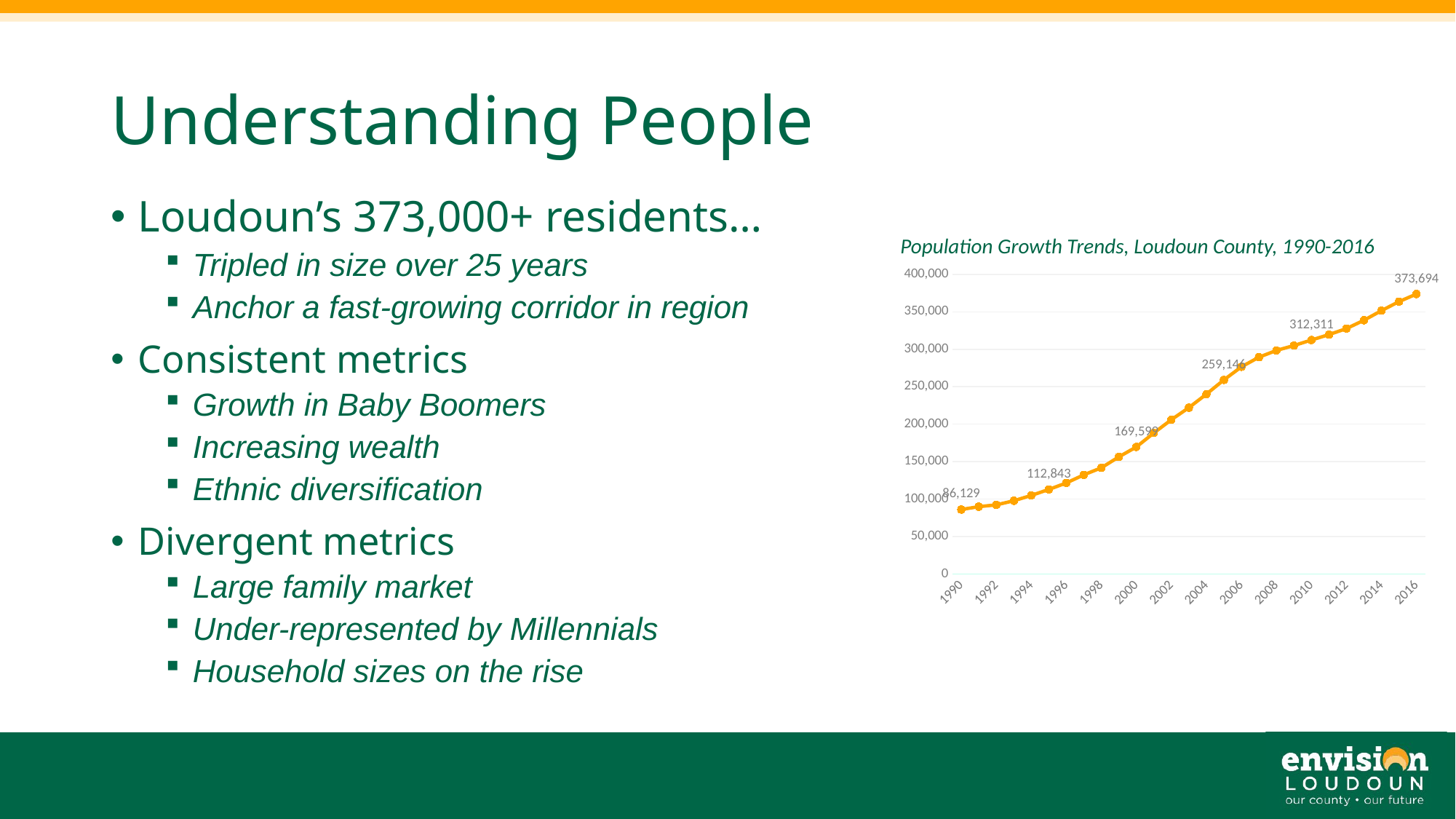
What is the population value shown for 2016? 373,694 What is the difference between the 2016 value (373,694) and the 1990 value (86,129)? 287,565 What type of chart is shown on the slide? Line chart Which year has the lowest population value? 1990 Does the population rise or fall from 1990 to 2016? Rise What is the population value labelled for 2000? 169,599 Which year has the highest population value? 2016 What is the title of the chart? Population Growth Trends, Loudoun County, 1990-2016 Is the value for 2008 greater or less than 250,000? greater What is the population value labelled for 2010? 312,311 What is the difference between the 2016 value (373,694) and the 2010 value (312,311)? 61,383 What is the population value shown for 1990? 86,129